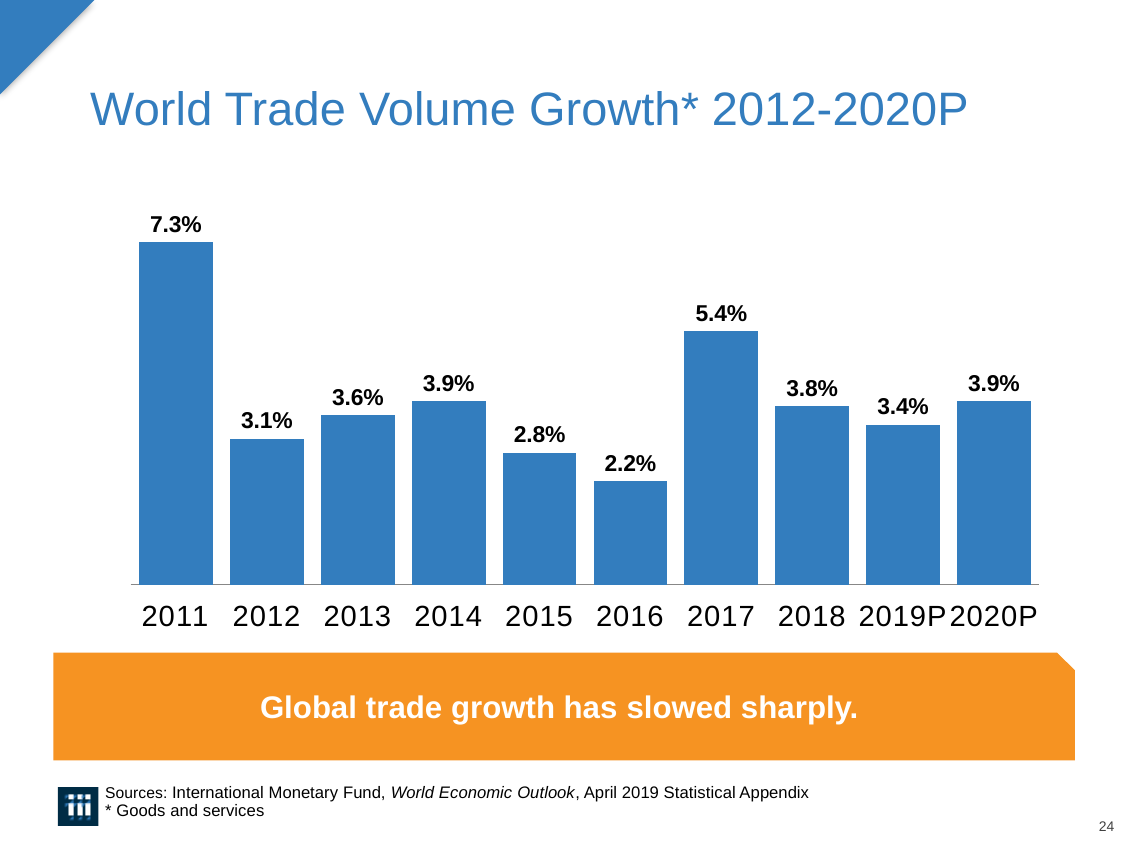
What is the world trade volume growth value for 2019P? 3.4% What is the title of the chart on the slide? World Trade Volume Growth* 2012-2020P Which year has the lowest world trade volume growth? 2016 What kind of chart is shown on the slide? Bar chart How many years are shown on the x axis of the chart? 10 Which year has the highest world trade volume growth? 2011 What is the world trade volume growth value for 2011? 7.3% What is the world trade volume growth value for 2017? 5.4% What is the difference between the growth values for 2017 and 2018? 1.6% Which is larger, the growth value for 2015 or for 2016? 2015 What is the difference between the growth values for 2011 and 2012? 4.2% What is the world trade volume growth value for 2016? 2.2%